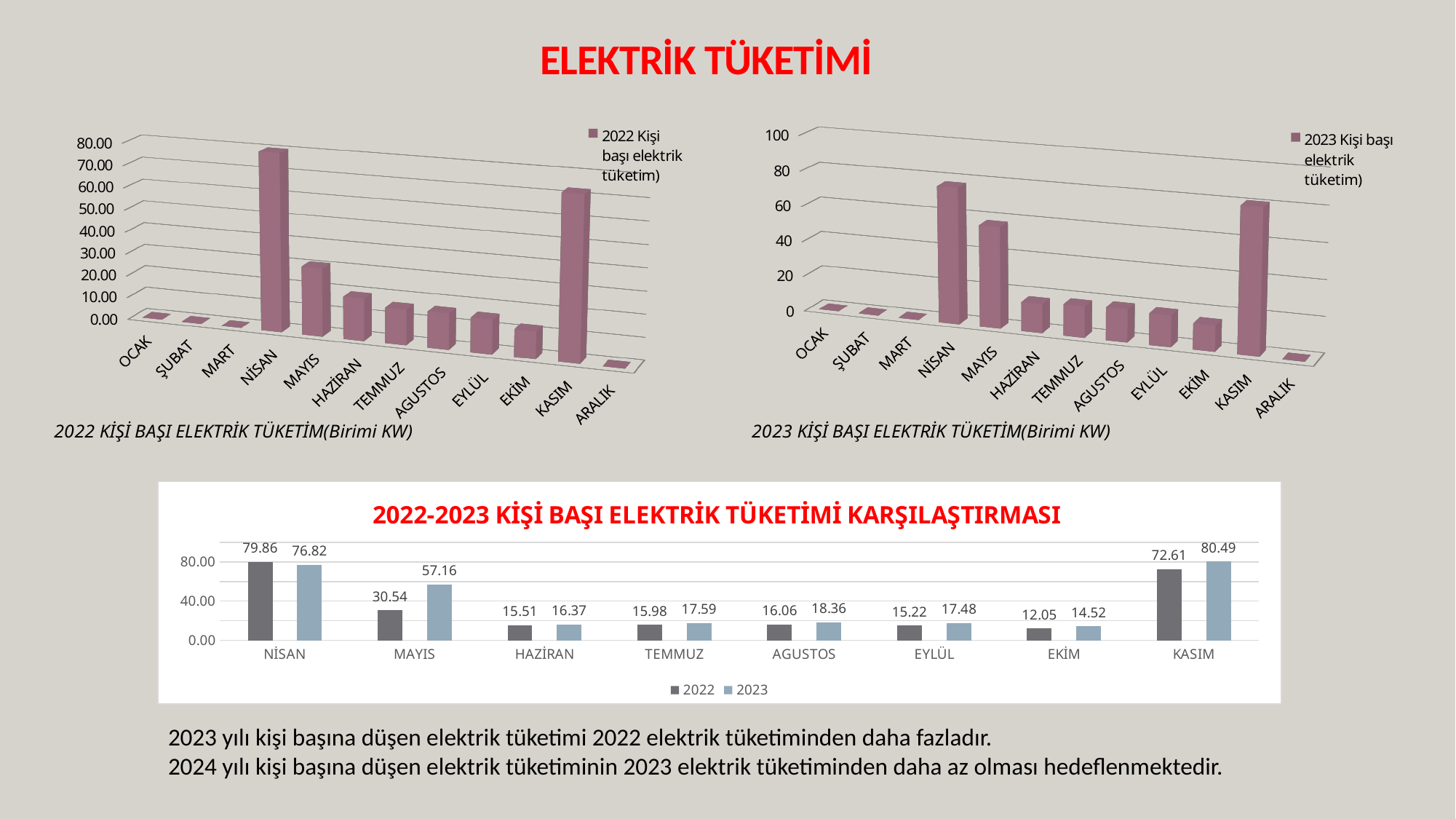
In the bottom comparison chart, what is the difference between the 2023 and 2022 values for MAYIS? 26.62 In the top-left chart (2022 KİŞİ BAŞI ELEKTRİK TÜKETİM), is the value for MAYIS greater or less than 40.00? less In the top-left chart (2022 KİŞİ BAŞI ELEKTRİK TÜKETİM), which month has the highest bar? NİSAN How many months are shown on the x axis of the top-right chart (2023 KİŞİ BAŞI ELEKTRİK TÜKETİM)? 12 In the top-right chart (2023 KİŞİ BAŞI ELEKTRİK TÜKETİM), is the value for MAYIS greater or less than 40? greater In the bottom comparison chart, which month has the highest 2023 value? KASIM In the bottom comparison chart, which is larger for NİSAN: the 2022 value or the 2023 value? 2022 In the bottom chart titled '2022-2023 KİŞİ BAŞI ELEKTRİK TÜKETİMİ KARŞILAŞTIRMASI', what is the 2023 value for MAYIS? 57.16 How many months are shown on the x axis of the bottom comparison chart? 8 In the bottom comparison chart, which month has the lowest 2022 value? EKİM How many series does the legend of the bottom comparison chart list? 2 In the bottom comparison chart, what is the 2022 value for KASIM? 72.61